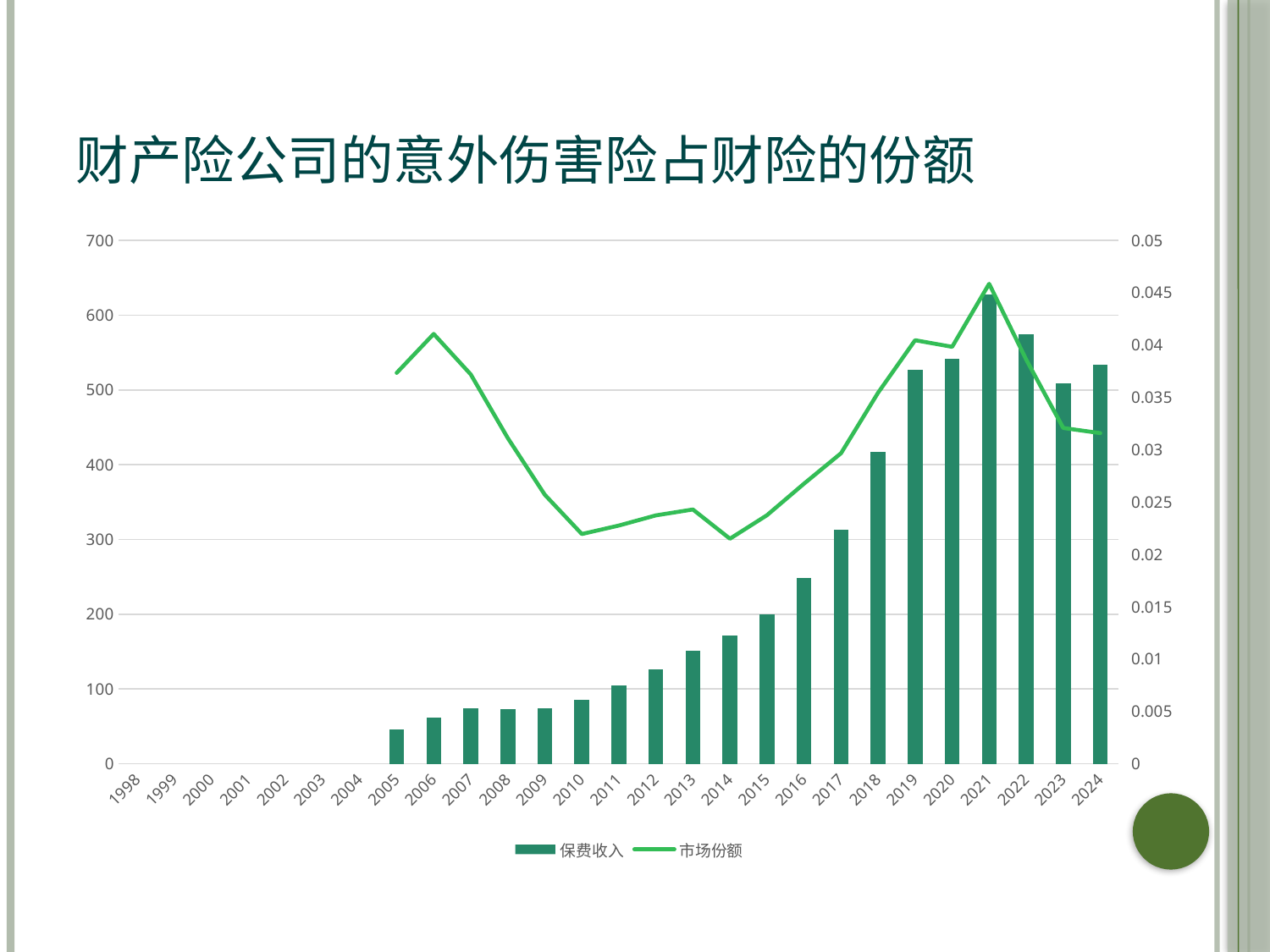
What kind of chart is shown on the slide? A combination bar and line chart What are the two series named in the legend? 保费收入 and 市场份额 Is the 保费收入 bar for 2005 greater or less than 100? less In which year does the 市场份额 line reach its highest point? 2021 Do the 保费收入 bars rise or fall from 2005 to 2021? rise How many series does the legend list? 2 Which year has the larger 保费收入 bar, 2022 or 2023? 2022 In which year is the 保费收入 bar the highest? 2021 How many years are labelled on the x axis? 27 Is the 市场份额 value for 2014 greater or less than 0.025? less Is the 保费收入 bar for 2021 greater or less than 600? greater